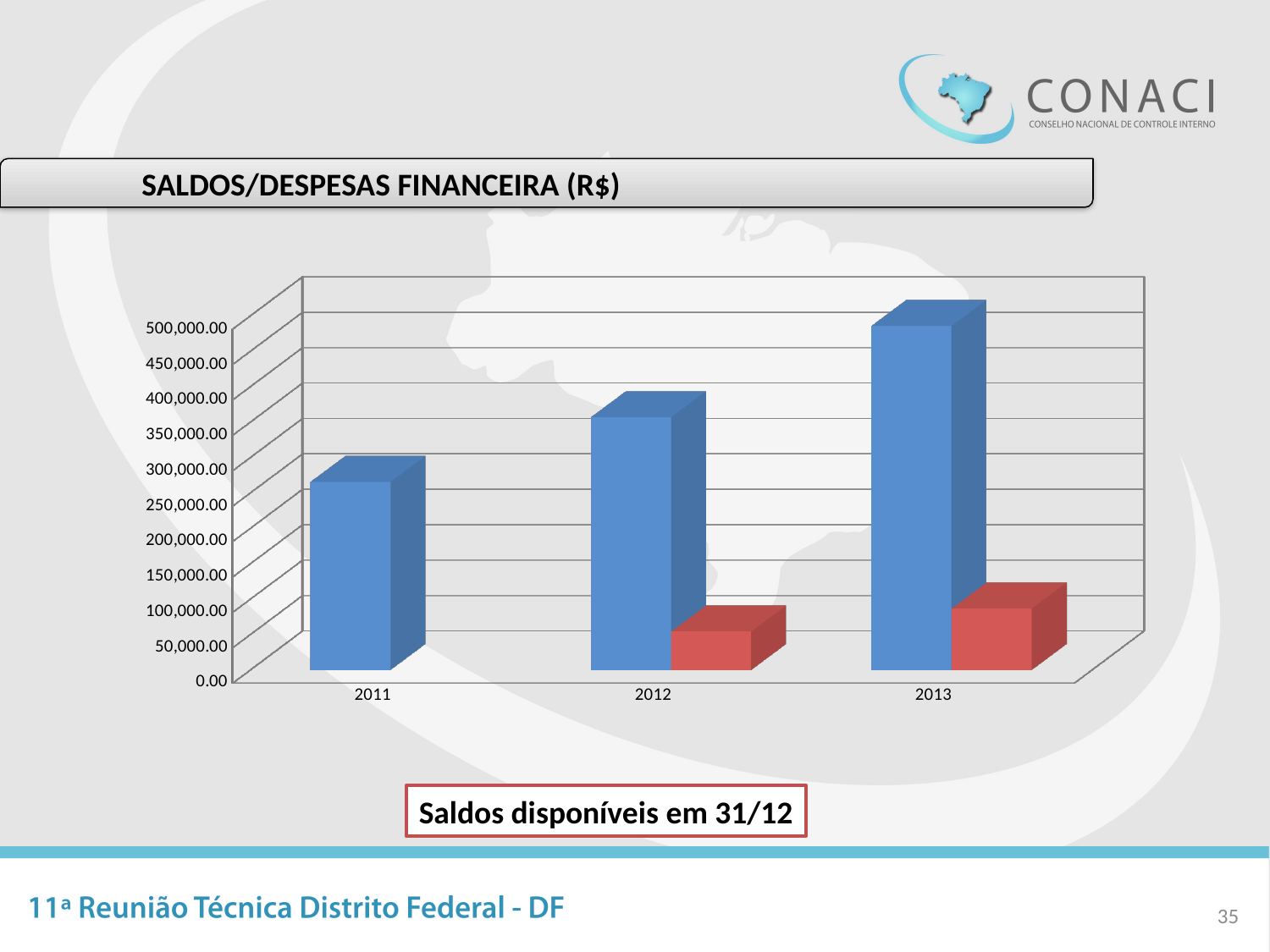
Is the value of the blue bar for 2013 greater or less than 400,000.00? greater What kind of chart is shown on the slide? bar chart How many years are shown on the x axis of the chart? 3 Is the value of the blue bar for 2011 greater or less than 200,000.00? greater Do the blue bars rise or fall from 2011 to 2013? rise Which year has the tallest blue bar? 2013 Which year has the larger blue bar, 2012 or 2013? 2013 Is the value of the red bar for 2012 greater or less than 100,000.00? less Which year has the shortest blue bar? 2011 Which year on the chart has no red bar? 2011 What is the title of the chart? SALDOS/DESPESAS FINANCEIRA (R$) Which year has the larger red bar, 2012 or 2013? 2013